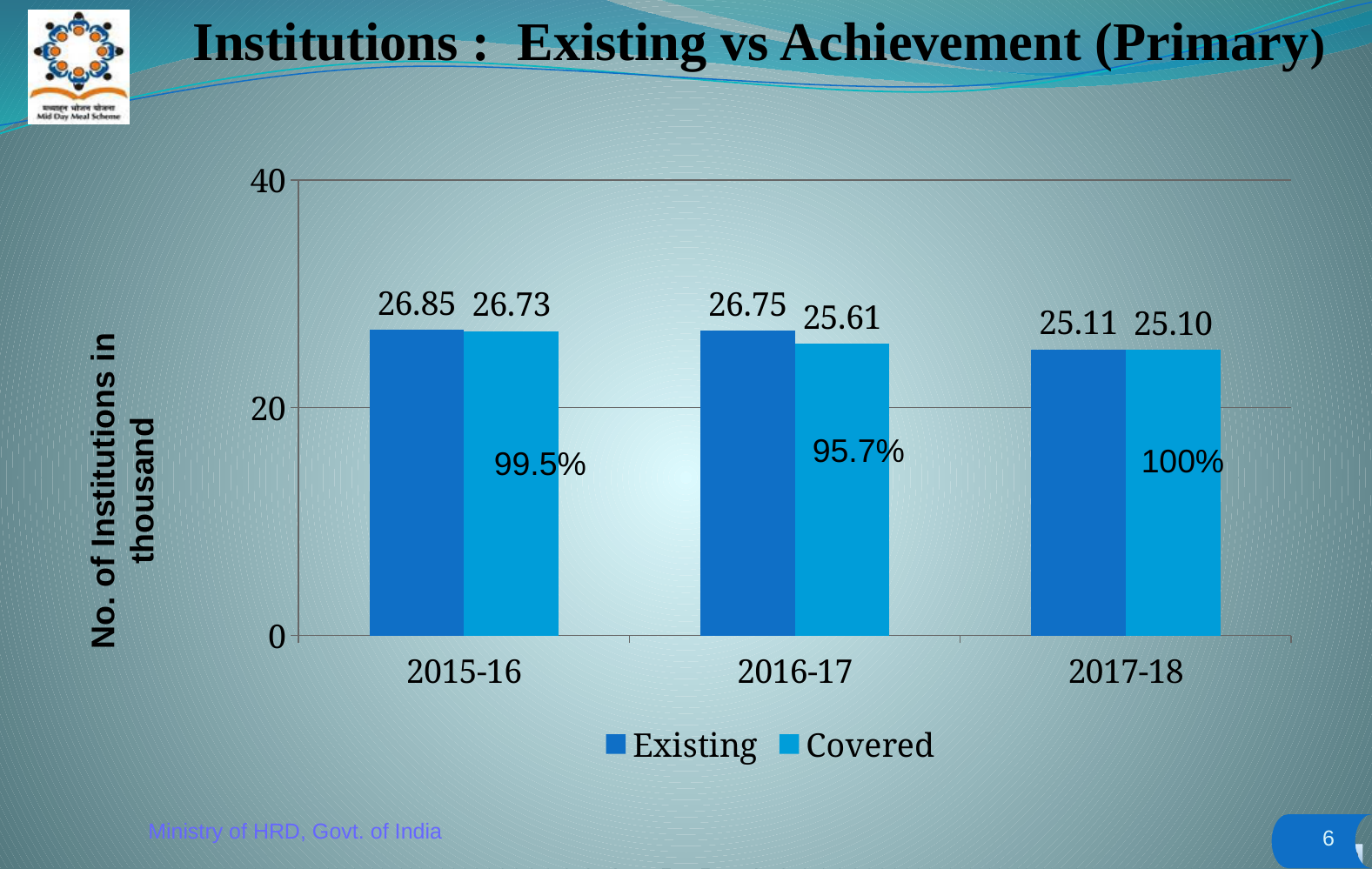
What is the Covered value for 2017-18? 25.10 How many years are shown on the x axis? 3 Which year has the highest Covered value? 2015-16 What is the Covered value for 2016-17? 25.61 Is the Existing value for 2017-18 greater or less than 20? greater Which year has the lowest Existing value? 2017-18 Is the Covered value for 2016-17 larger or smaller than the Covered value for 2015-16? smaller What kind of chart is shown on the slide? bar chart What is the difference between the Existing and Covered values for 2016-17? 1.14 What is the Existing value for 2015-16? 26.85 How many series does the legend list? 2 Do the Existing values rise or fall from 2015-16 to 2017-18? fall